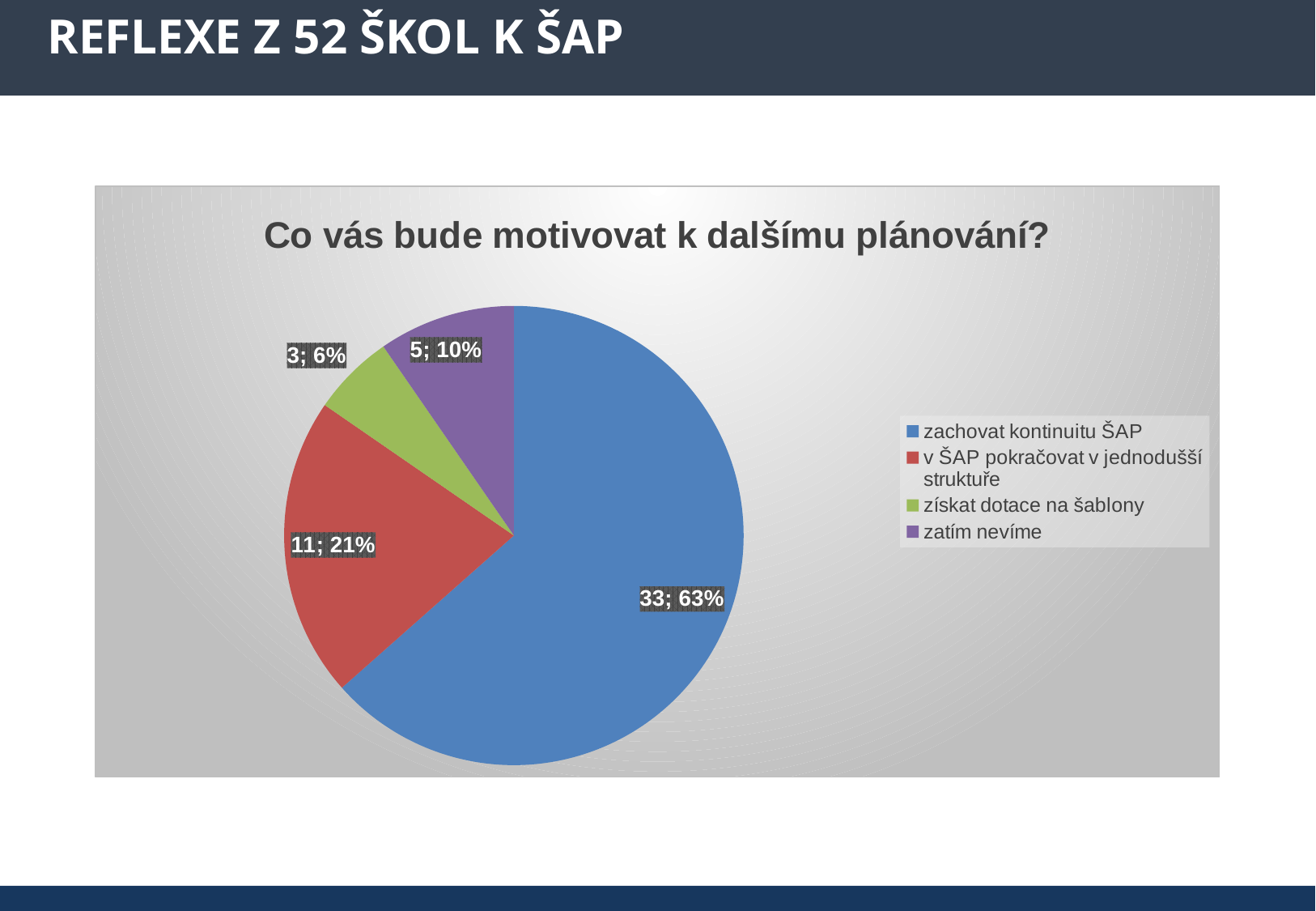
What kind of chart is shown on the slide? pie chart What is the count for 'zatím nevíme'? 5 How many slices does the pie chart have? 4 Which category has the smallest slice? získat dotace na šablony What is the title of the chart? Co vás bude motivovat k dalšímu plánování? What is the count for 'zachovat kontinuitu ŠAP'? 33 What percentage share does 'získat dotace na šablony' have? 6% What percentage share does 'zachovat kontinuitu ŠAP' have? 63% Which category has the largest slice? zachovat kontinuitu ŠAP What is the difference in count between 'zachovat kontinuitu ŠAP' and 'v ŠAP pokračovat v jednodušší struktuře'? 22 What is the count for 'v ŠAP pokračovat v jednodušší struktuře'? 11 How many entries does the legend list? 4